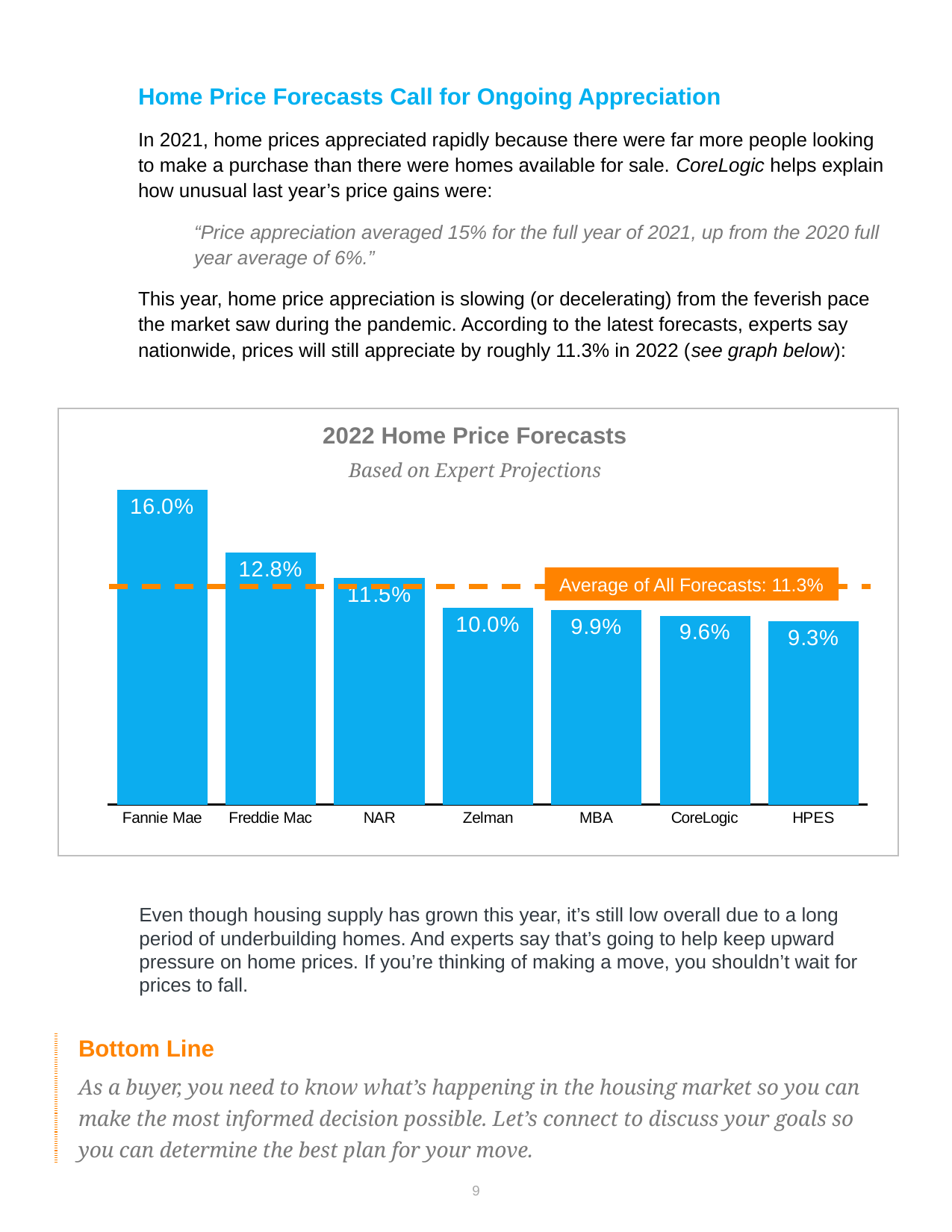
What is the 2022 home price forecast for Fannie Mae? 16.0% Which forecast is larger, Freddie Mac or NAR? Freddie Mac Do the forecast values rise or fall from left to right across the chart? Fall How many forecasters are shown in the chart? 7 What kind of chart is shown on the slide? Bar chart Which forecaster has the lowest 2022 home price forecast? HPES What is the 2022 home price forecast for Zelman? 10.0% What value does the dashed orange line labeled 'Average of All Forecasts' represent? 11.3% Which forecaster has the highest 2022 home price forecast? Fannie Mae What is the difference between the Fannie Mae and Freddie Mac forecasts? 3.2% What is the 2022 home price forecast for CoreLogic? 9.6% What is the difference between the NAR and HPES forecasts? 2.2%